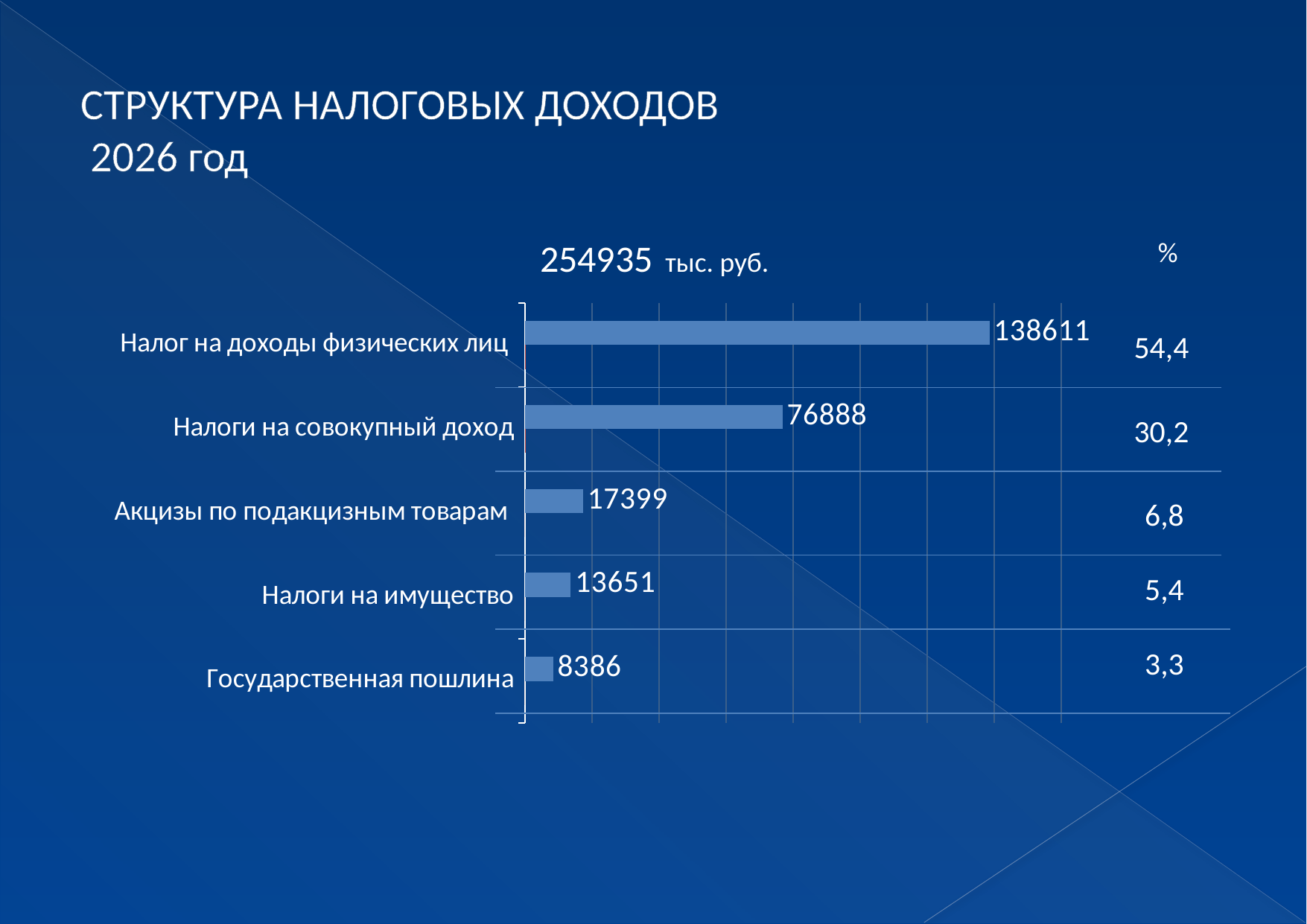
What value is shown for Налоги на совокупный доход? 76888 Which is larger: Акцизы по подакцизным товарам or Налоги на имущество? Акцизы по подакцизным товарам What is the difference between Акцизы по подакцизным товарам and Налоги на имущество? 3748 What kind of chart is shown on the slide? Bar chart What percentage share is shown next to Налоги на совокупный доход? 30,2 Which category has the lowest value? Государственная пошлина What total amount in тыс. руб. is shown above the chart? 254935 What is the difference between Налог на доходы физических лиц and Налоги на совокупный доход? 61723 Which category has the highest value? Налог на доходы физических лиц What value is shown for Налог на доходы физических лиц? 138611 How many categories are shown in the chart? 5 What value is shown for Государственная пошлина? 8386